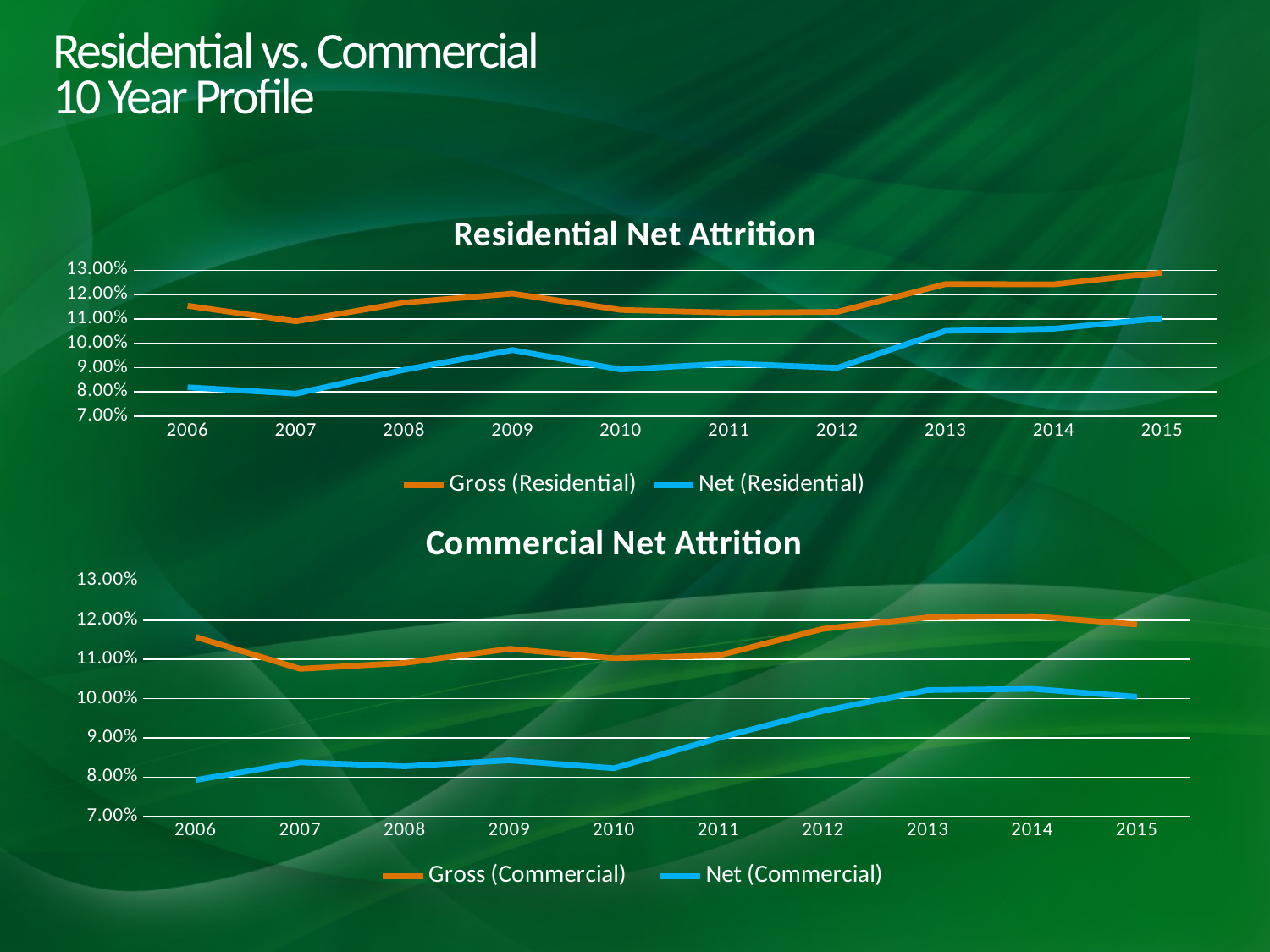
What are the two legend entries of the Commercial Net Attrition chart? Gross (Commercial) and Net (Commercial) In the Commercial Net Attrition chart, does the Net (Commercial) line rise or fall from 2010 to 2013? rise In the Commercial Net Attrition chart, is the Gross (Commercial) value for 2007 greater or less than 11.00%? less How many years are shown on the x axis of the Residential Net Attrition chart? 10 In the Residential Net Attrition chart, which year has the highest Gross (Residential) value? 2015 How many series does the legend of the Residential Net Attrition chart list? 2 What kind of chart is the Residential Net Attrition chart? line chart In the Residential Net Attrition chart, is the Net (Residential) value for 2006 greater or less than 9.00%? less In the Commercial Net Attrition chart, which year has the lowest Net (Commercial) value? 2006 In the Residential Net Attrition chart, which series is higher in 2009, Gross (Residential) or Net (Residential)? Gross (Residential) In the Residential Net Attrition chart, is the Gross (Residential) value for 2015 greater or less than 12.00%? greater In the Residential Net Attrition chart, which year has the lowest Gross (Residential) value? 2007